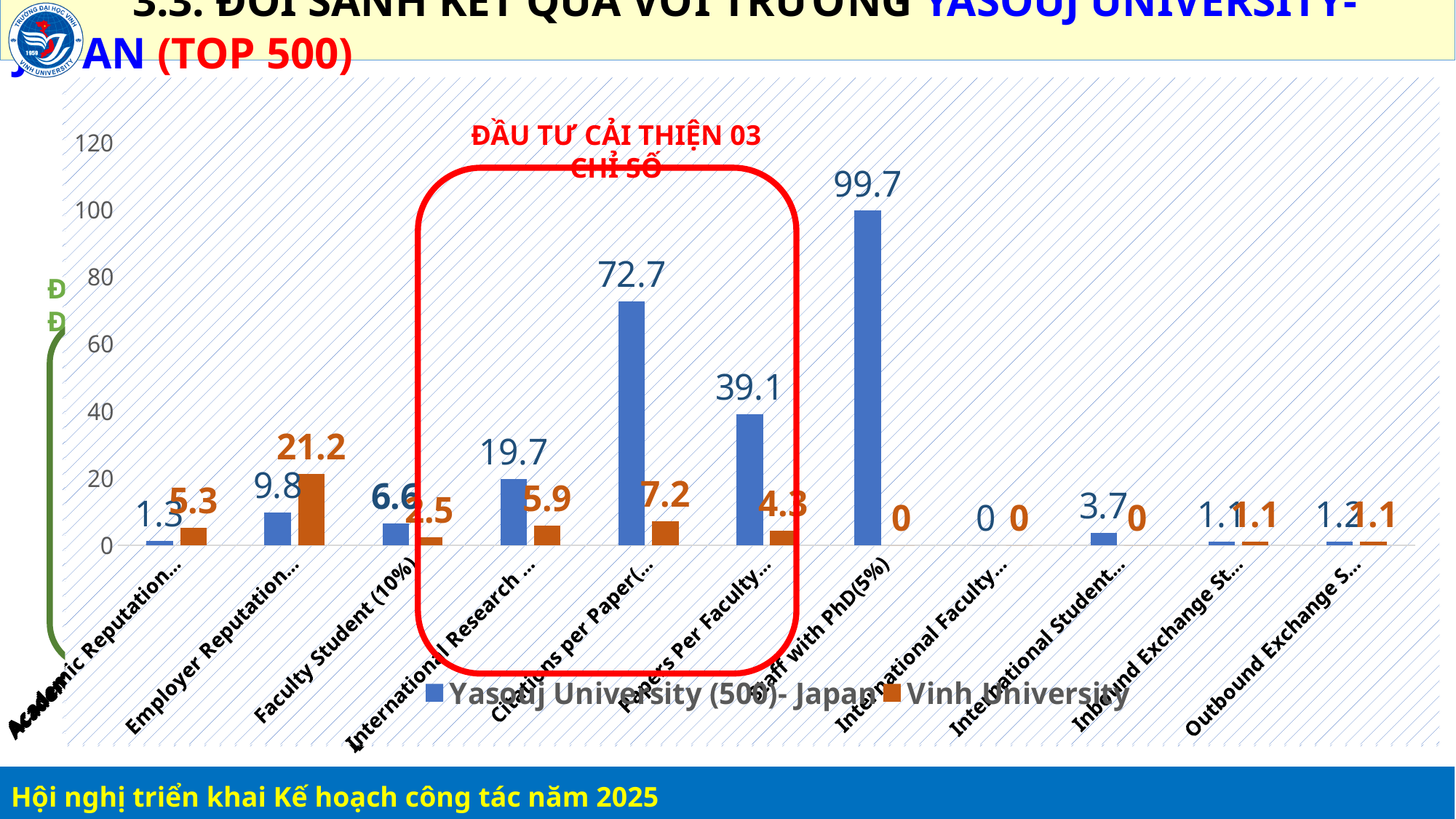
In which category does Yasouj University (500)- Japan have its highest value? Staff with PhD(5%) What kind of chart is shown on the slide? bar chart What is the value for Yasouj University (500)- Japan in the Citations per Paper category? 72.7 How many categories are plotted along the x axis of the chart? 11 Is the value for Yasouj University (500)- Japan in the Staff with PhD(5%) category greater or less than 80? greater What is the value for Yasouj University (500)- Japan in the Papers Per Faculty category? 39.1 What is the difference between the Yasouj University (500)- Japan value and the Vinh University value in the Citations per Paper category? 65.5 In the Faculty Student (10%) category, which series has the larger value? Yasouj University (500)- Japan How many series does the chart legend list? 2 What is the value for Vinh University in the Employer Reputation category? 21.2 In which category does Vinh University have its highest value? Employer Reputation What colour are the bars for Vinh University in the chart? orange